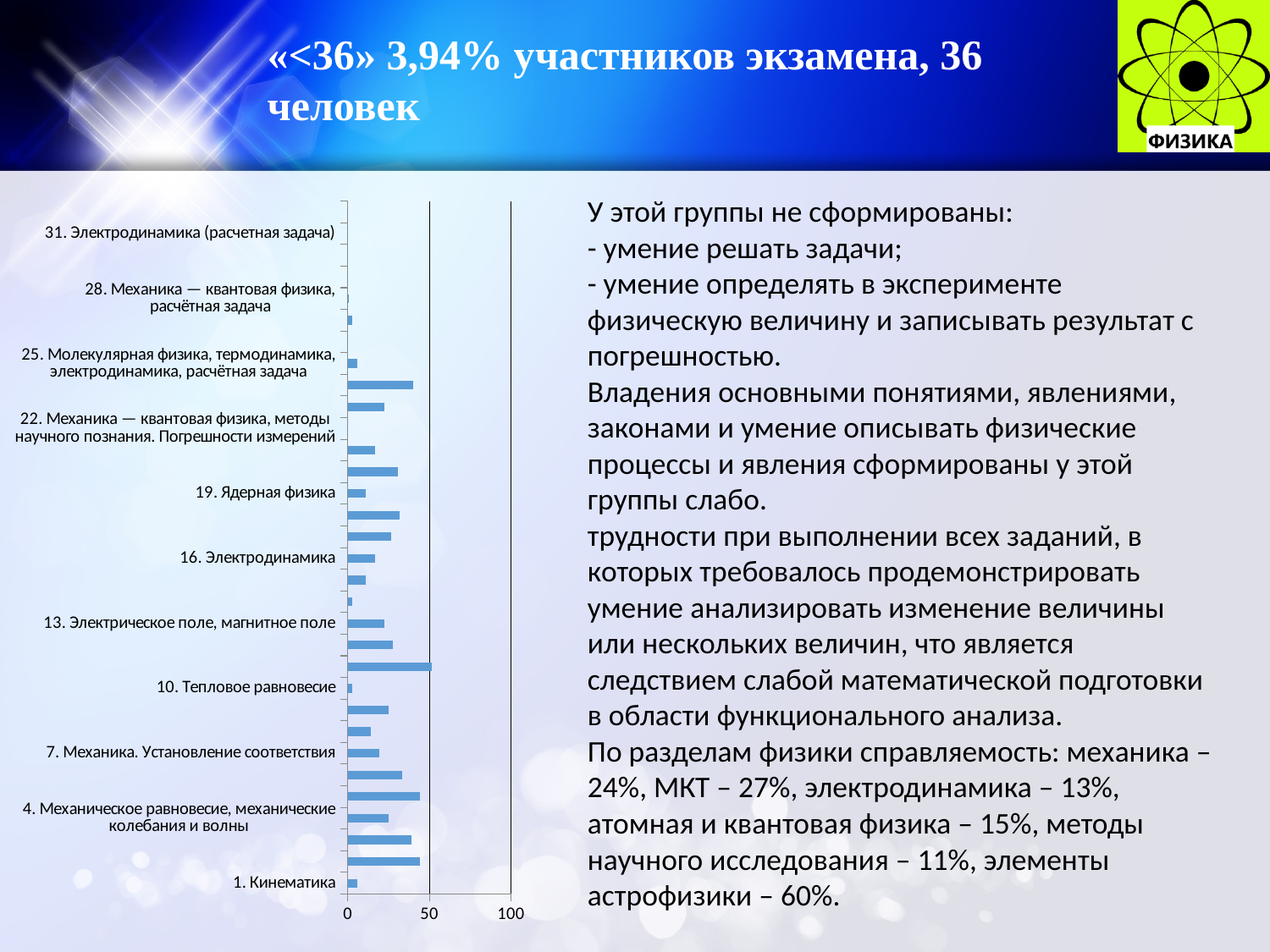
Is the value for "1. Кинематика" greater or less than 50? less Is the value for "7. Механика. Установление соответствия" greater or less than 50? less Is the value for "13. Электрическое поле, магнитное поле" greater or less than 50? less Which has the larger value: "1. Кинематика" or "4. Механическое равновесие, механические колебания и волны"? 4. Механическое равновесие, механические колебания и волны What is the highest value shown on the chart's value axis? 100 What is the label of the topmost category on the chart's axis? 31. Электродинамика (расчетная задача) What kind of chart is shown on the slide? bar chart Are the bars in the chart horizontal or vertical? horizontal